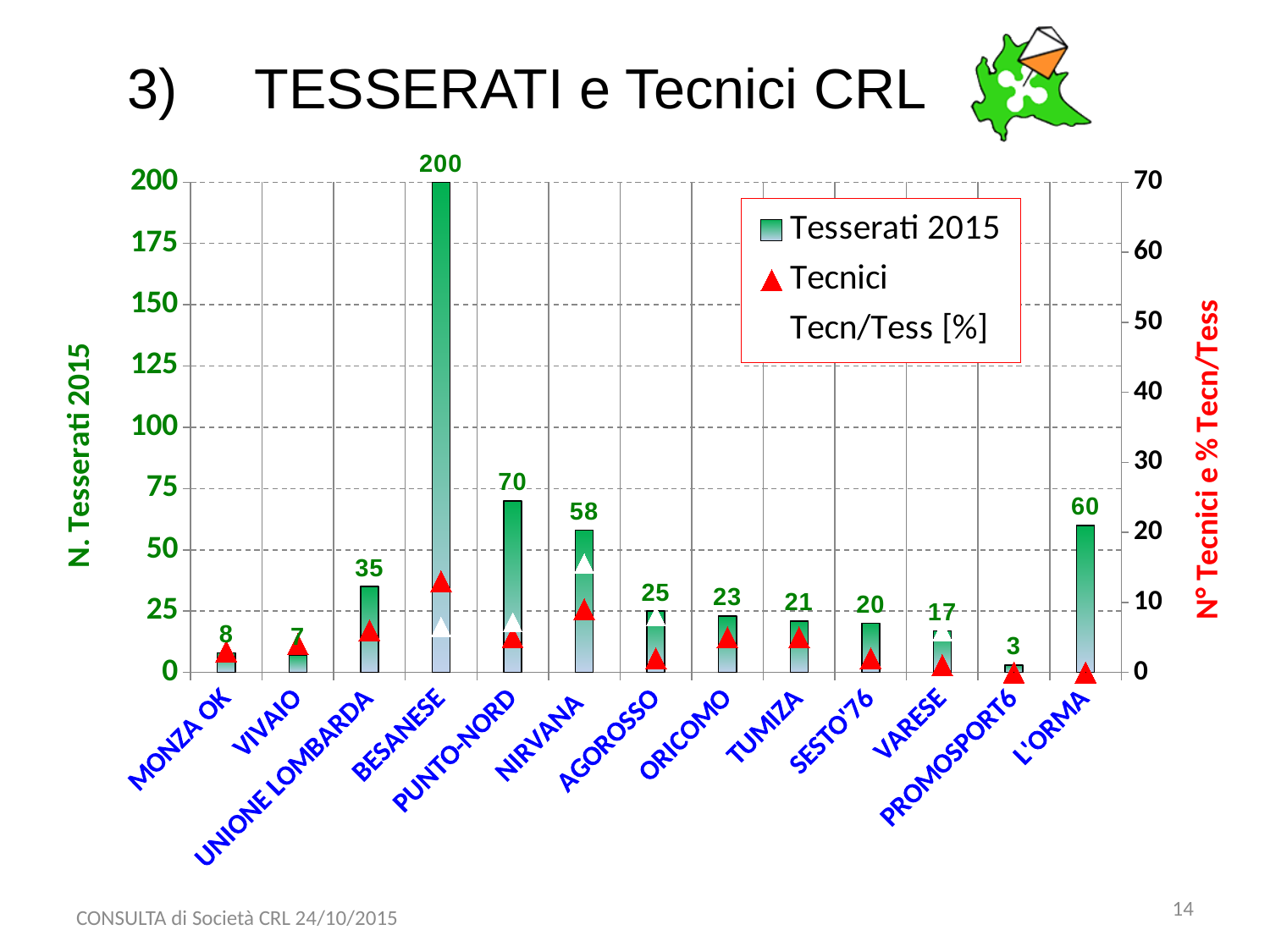
How many societies are shown on the x axis? 13 What is the Tesserati 2015 value for VARESE? 17 What is the Tesserati 2015 value for PUNTO-NORD? 70 What is the Tesserati 2015 value for BESANESE? 200 How many entries does the legend list? 3 What kind of chart is used for the Tesserati 2015 series? Bar chart Which society has the lowest Tesserati 2015 value? PROMOSPORT6 What is the label of the right-hand vertical axis? N° Tecnici e % Tecn/Tess Is the Tecnici value for BESANESE (right axis) greater or less than 10? greater What is the difference between the Tesserati 2015 values of PUNTO-NORD and NIRVANA? 12 Which society has the highest Tesserati 2015 value? BESANESE Which has a higher Tesserati 2015 value, L'ORMA or NIRVANA? L'ORMA